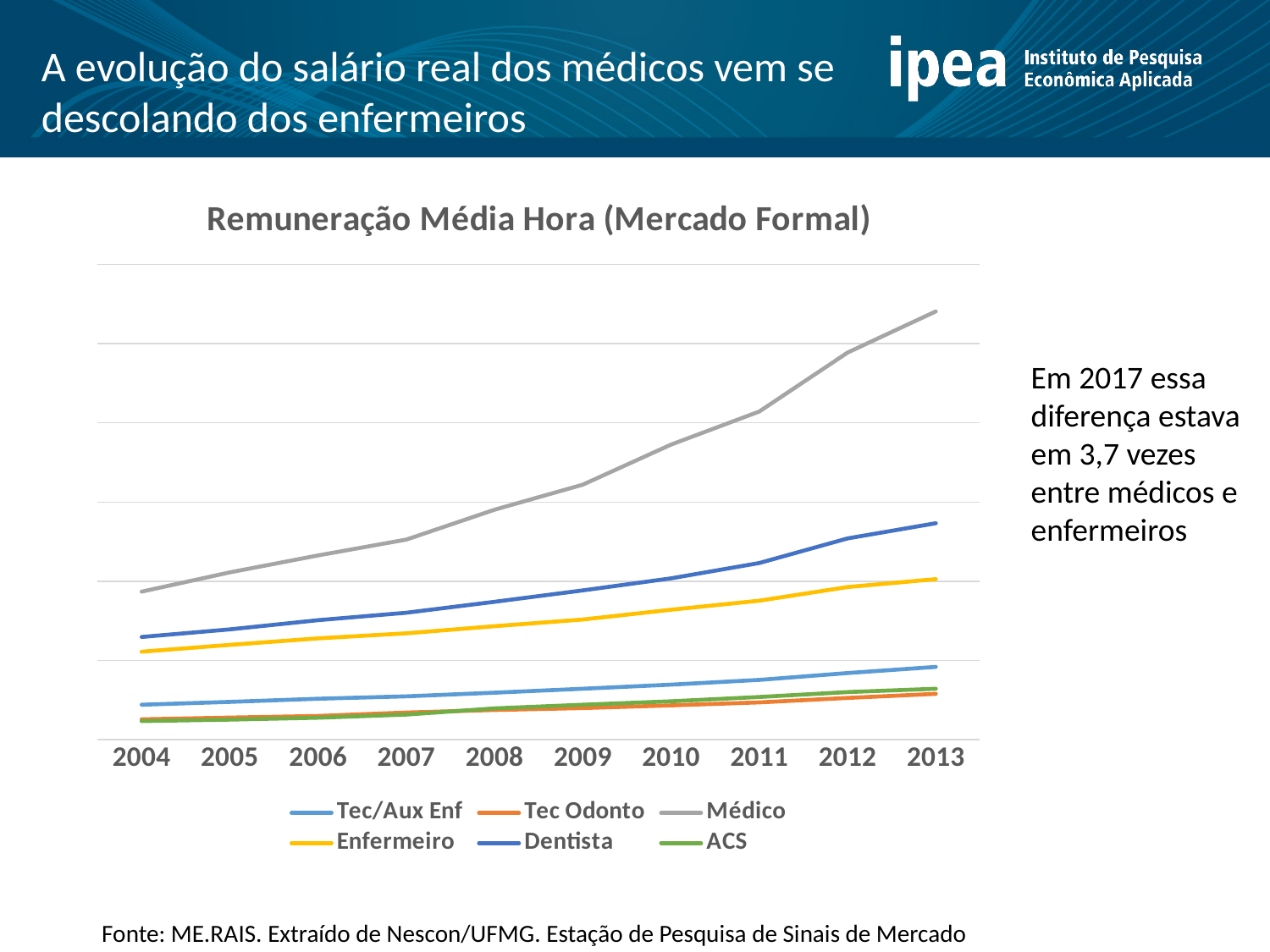
Does the Enfermeiro series rise or fall from 2004 to 2013? Rise What kind of chart is shown on the slide? Line chart In 2013, which is larger: the value for Dentista or the value for Enfermeiro? Dentista Does the Médico series rise or fall from 2004 to 2013? Rise In 2013, which is larger: the value for Tec/Aux Enf or the value for ACS? Tec/Aux Enf What colour is the line for the Médico series? Grey Which series has the second-highest value in 2013? Dentista What is the title of the chart? Remuneração Média Hora (Mercado Formal) Which series has the highest values across the whole period shown? Médico How many years are shown along the x axis of the chart? 10 How many series does the chart legend list? 6 In 2004, which is larger: the value for Médico or the value for Dentista? Médico